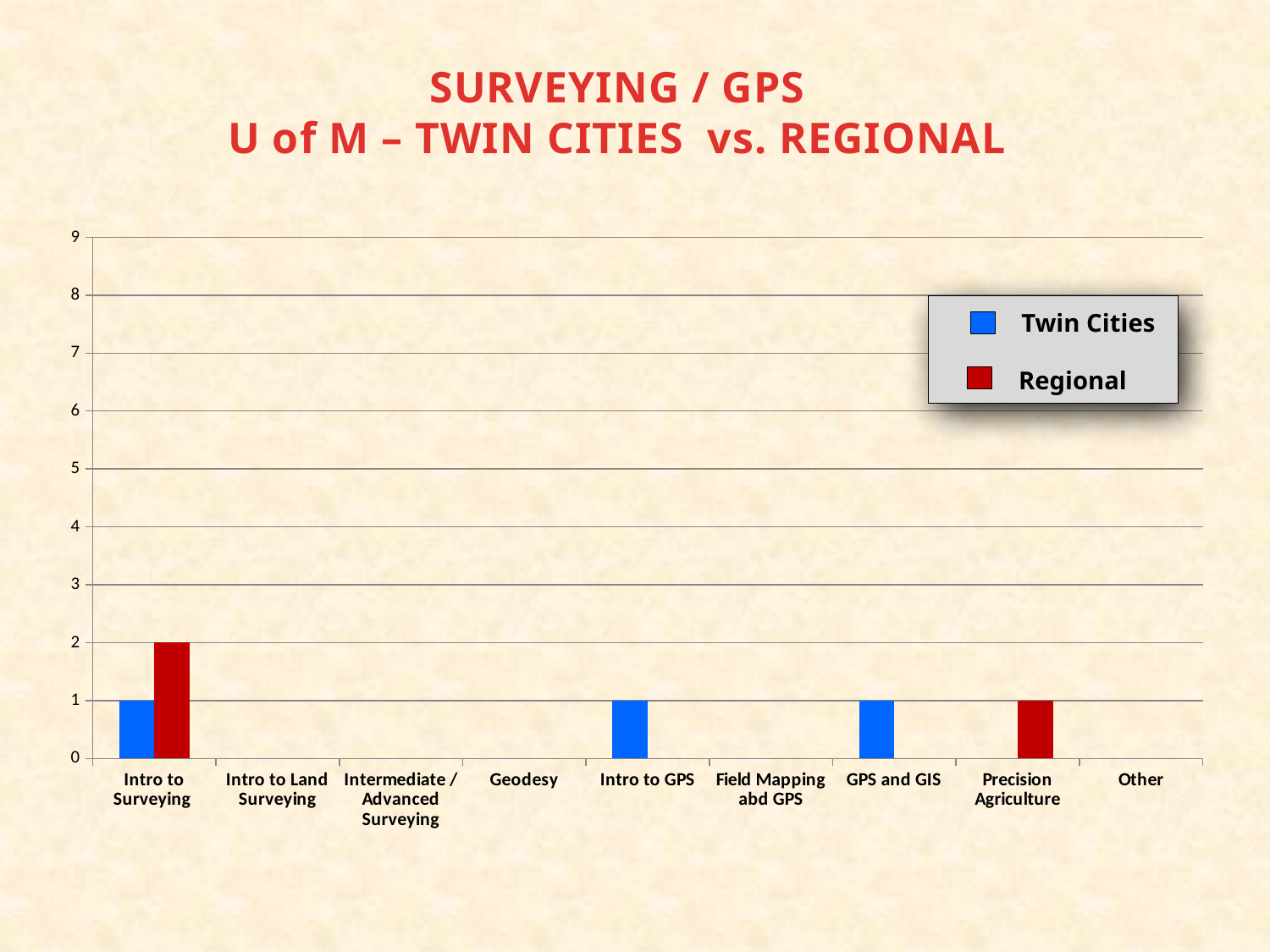
Which series is shown in red in the legend? Regional What is the Twin Cities value for Intro to GPS? 1 What kind of chart is shown on the slide? bar chart What is the title of the chart? SURVEYING / GPS U of M – TWIN CITIES vs. REGIONAL What is the Regional value for Precision Agriculture? 1 What is the Regional value for Intro to Surveying? 2 Which category has the highest Regional value? Intro to Surveying How many categories are shown on the x axis? 9 What is the Twin Cities value for Intro to Surveying? 1 How many series does the legend list? 2 For Intro to Surveying, which series has the larger value, Twin Cities or Regional? Regional What is the difference between the Regional and Twin Cities values for Intro to Surveying? 1